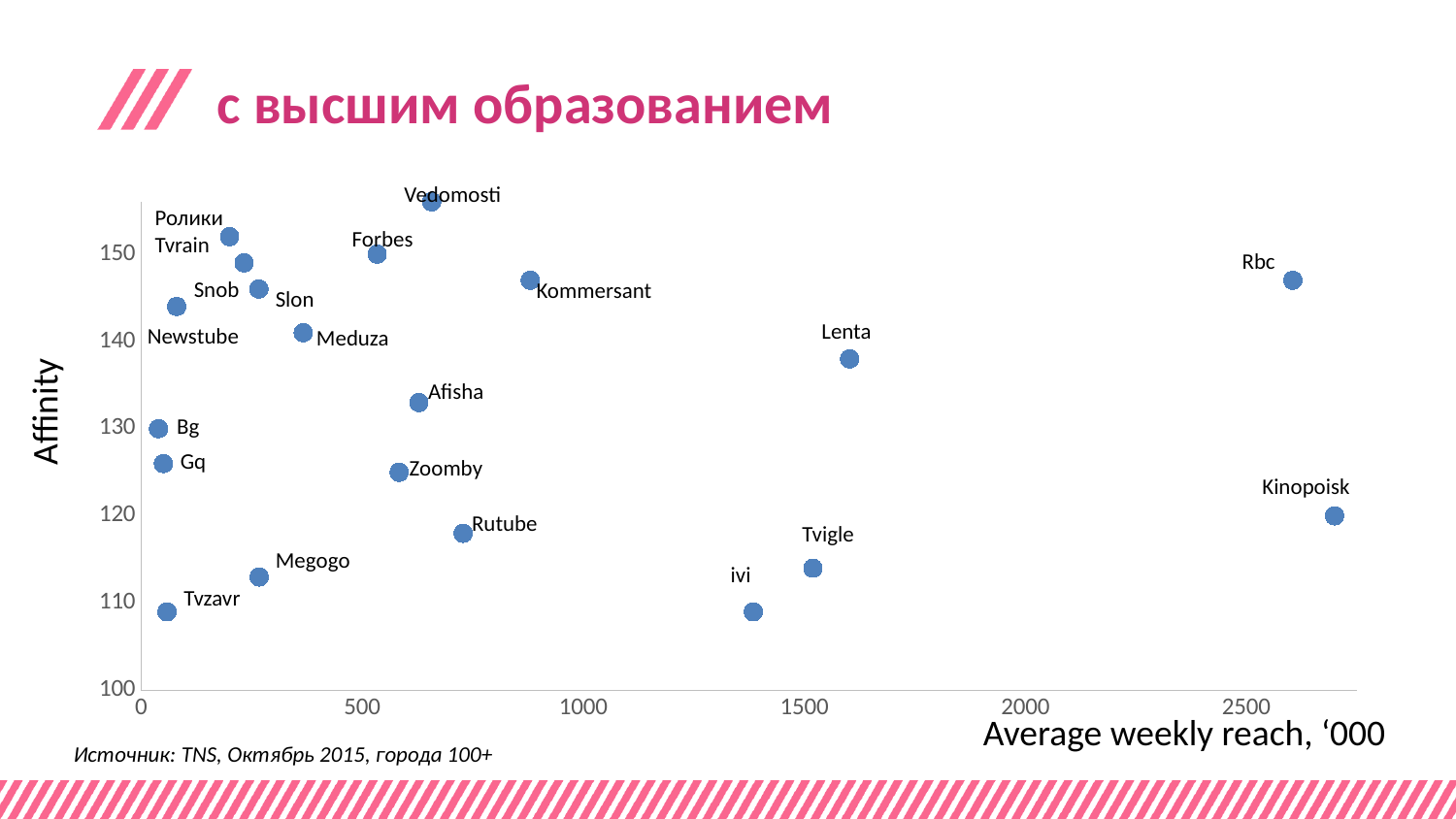
Which point has the highest average weekly reach? Kinopoisk What kind of chart is shown on the slide? scatter chart Which has the higher Affinity value, Rbc or Lenta? Rbc Is the Affinity value for Afisha greater or less than 130? greater Which has the higher Affinity value, Tvigle or ivi? Tvigle How many data points are plotted on the chart? 20 Is the Affinity value for Lenta greater or less than 140? less Is the average weekly reach for ivi greater or less than 1500? less What is the label of the horizontal axis? Average weekly reach, '000 Which point has the highest Affinity value? Vedomosti